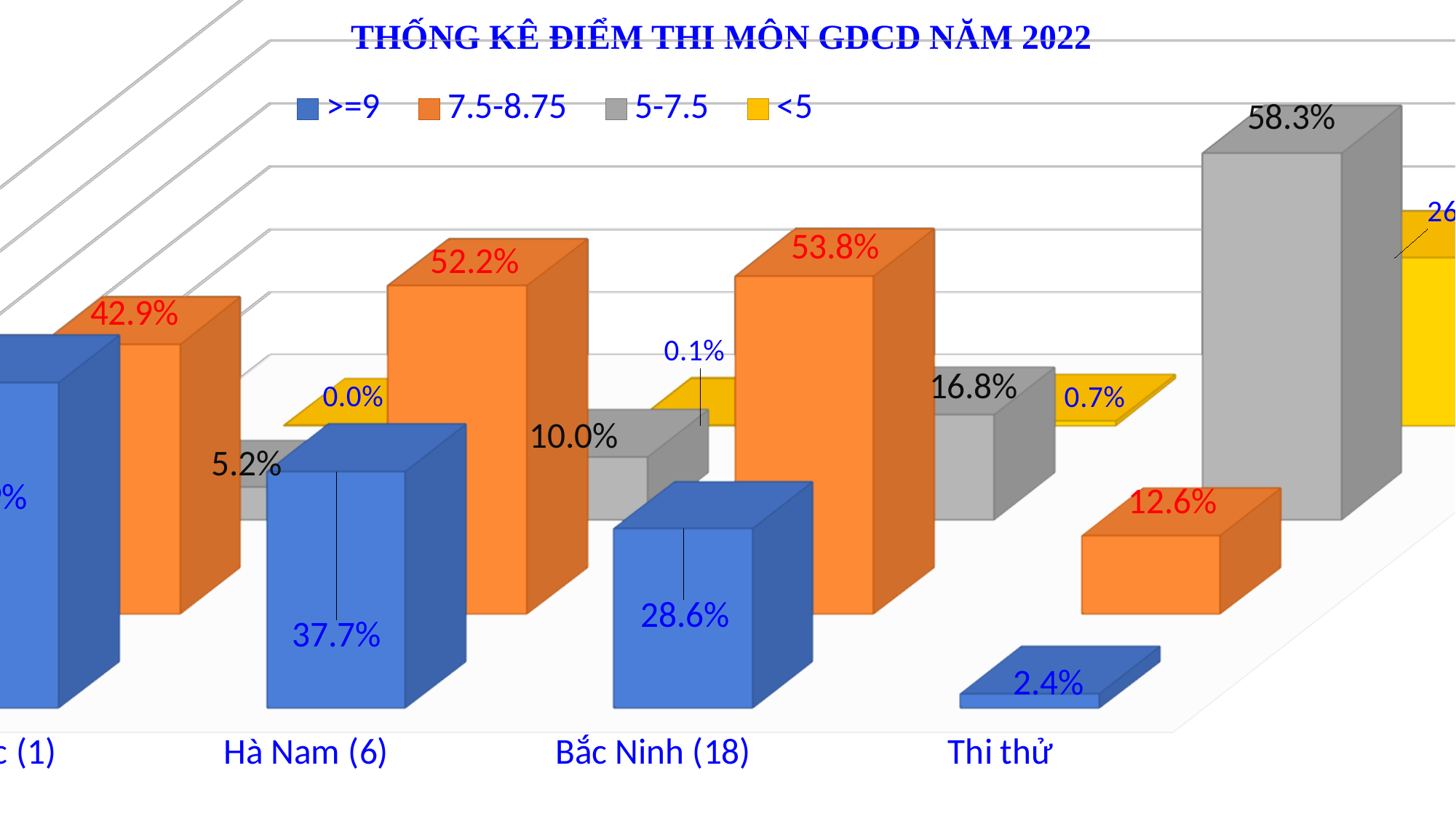
What is the value for Thi thử in the 5-7.5 series? 58.3% What is the value for Thi thử in the 7.5-8.75 series? 12.6% What is the title of the chart? THỐNG KÊ ĐIỂM THI MÔN GDCD NĂM 2022 What is the value for Hà Nam (6) in the >=9 series? 37.7% How many series does the legend list? 4 Which category has the lowest value in the >=9 series? Thi thử What is the value for Bắc Ninh (18) in the 7.5-8.75 series? 53.8% What is the value for Bắc Ninh (18) in the 5-7.5 series? 16.8% What is the difference between the >=9 values for Hà Nam (6) and Bắc Ninh (18)? 9.1% Which category has the highest value in the 5-7.5 series? Thi thử What is the value for Thi thử in the >=9 series? 2.4% Which is larger in the 7.5-8.75 series: Hà Nam (6) or Bắc Ninh (18)? Bắc Ninh (18)